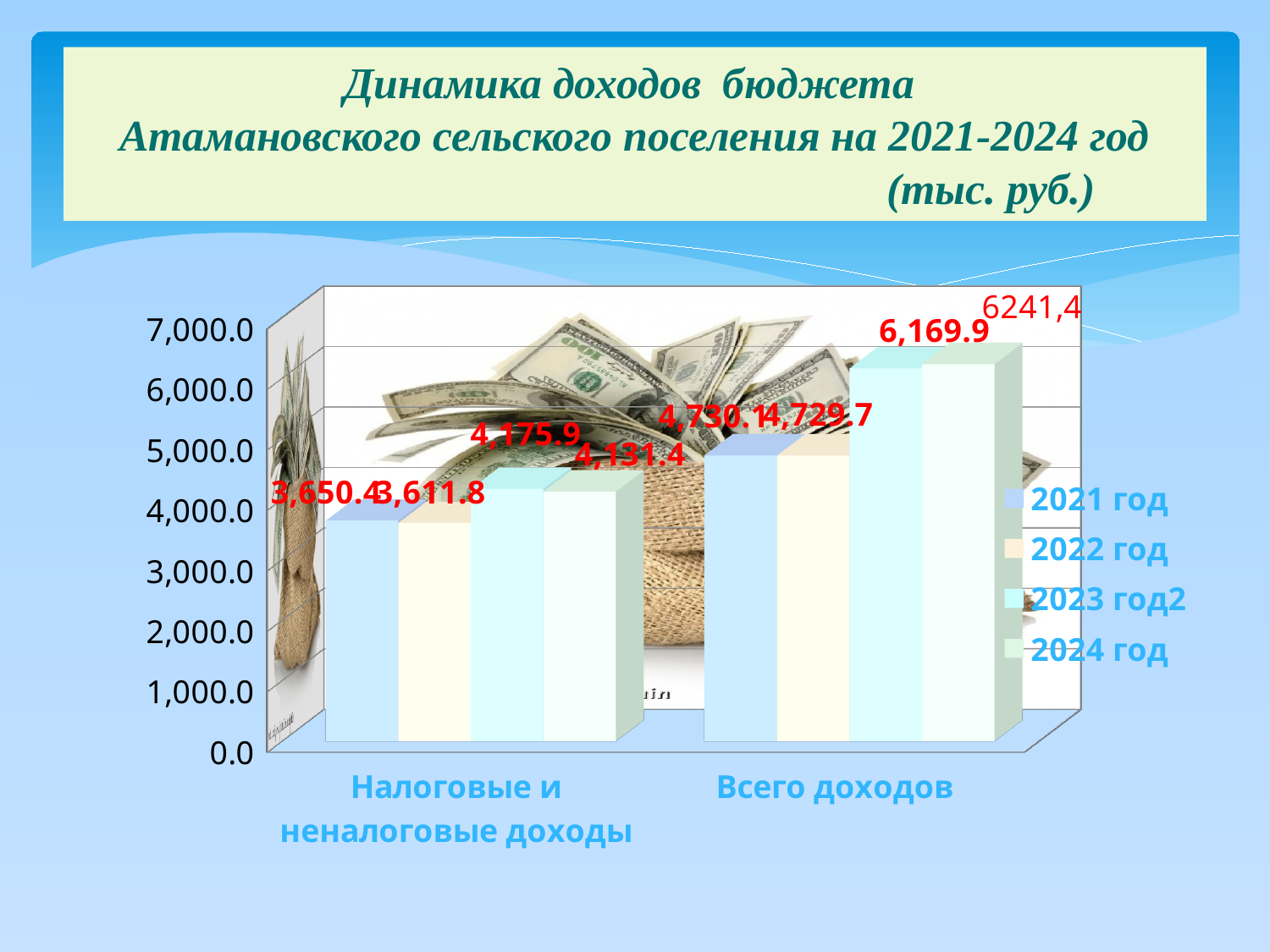
How many series does the chart legend list? 4 Is the value for 2022 год in the category Всего доходов greater or less than 5,000.0? less What is the value for 2024 год in the category Всего доходов? 6241,4 What is the value for 2023 год in the category Всего доходов? 6,169.9 Which year has the lowest value in the category Налоговые и неналоговые доходы? 2022 год How many categories are shown on the x axis of the chart? 2 What is the value for 2024 год in the category Налоговые и неналоговые доходы? 4,131.4 What is the difference between the 2023 год and 2022 год values in the category Налоговые и неналоговые доходы? 564.1 In the category Налоговые и неналоговые доходы, which is larger: the value for 2023 год or for 2024 год? 2023 год What is the value for 2021 год in the category Налоговые и неналоговые доходы? 3,650.4 What kind of chart is shown on the slide? bar chart Which year has the highest value in the category Всего доходов? 2024 год